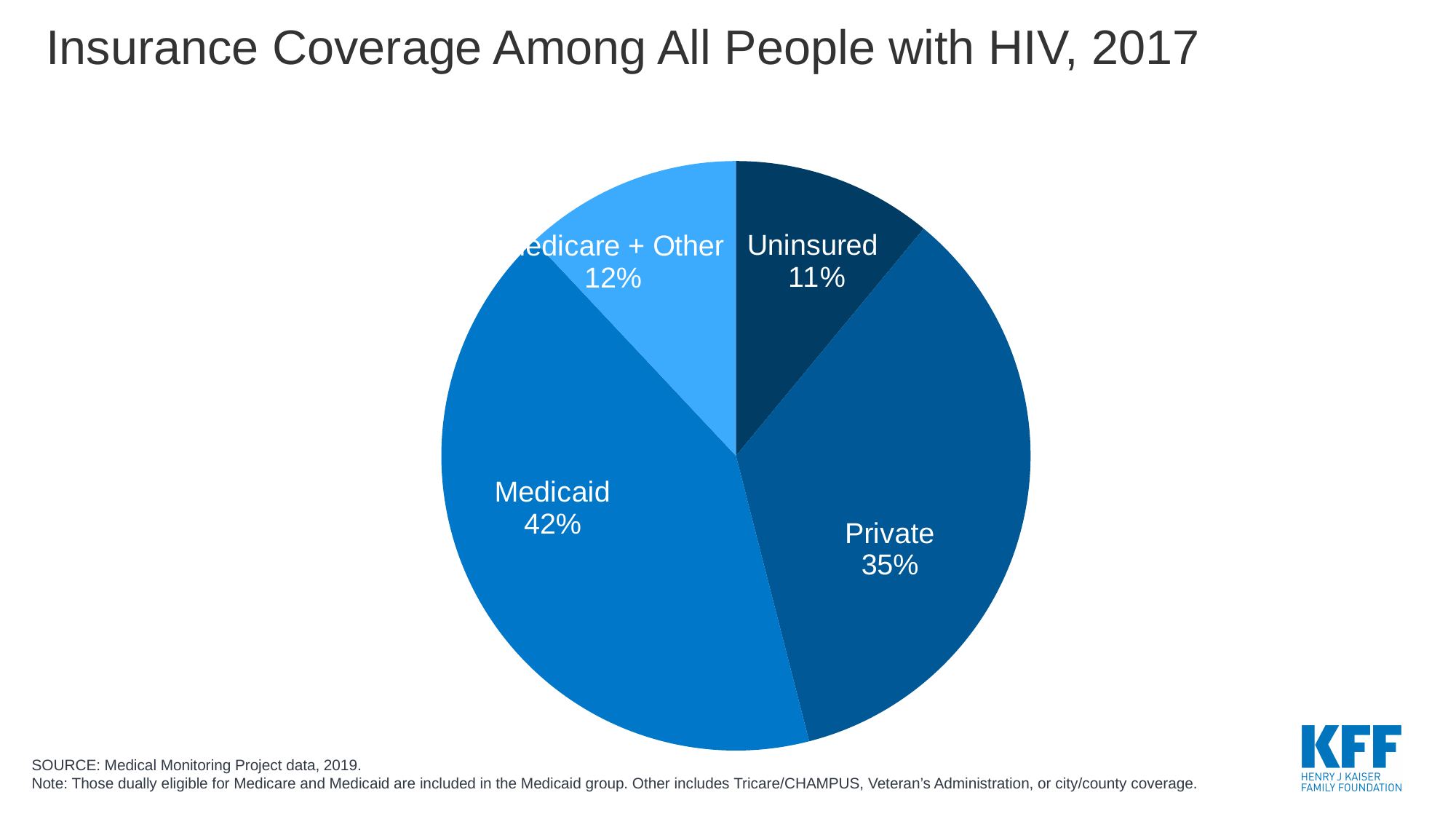
What is the difference in percentage points between the Medicaid and Private shares? 7 Which coverage category has the smallest share of the pie? Uninsured Which is larger, the Private share or the Medicare + Other share? Private What is the title of the chart? Insurance Coverage Among All People with HIV, 2017 What share of people with HIV are covered by Medicare + Other? 12% What kind of chart is shown on the slide? Pie chart What share of people with HIV are covered by Medicaid? 42% Which coverage category has the largest share of the pie? Medicaid What share of people with HIV are uninsured? 11% How many slices does the pie chart have? 4 What share of people with HIV have private insurance? 35% What is the combined share of Medicaid and Private coverage? 77%